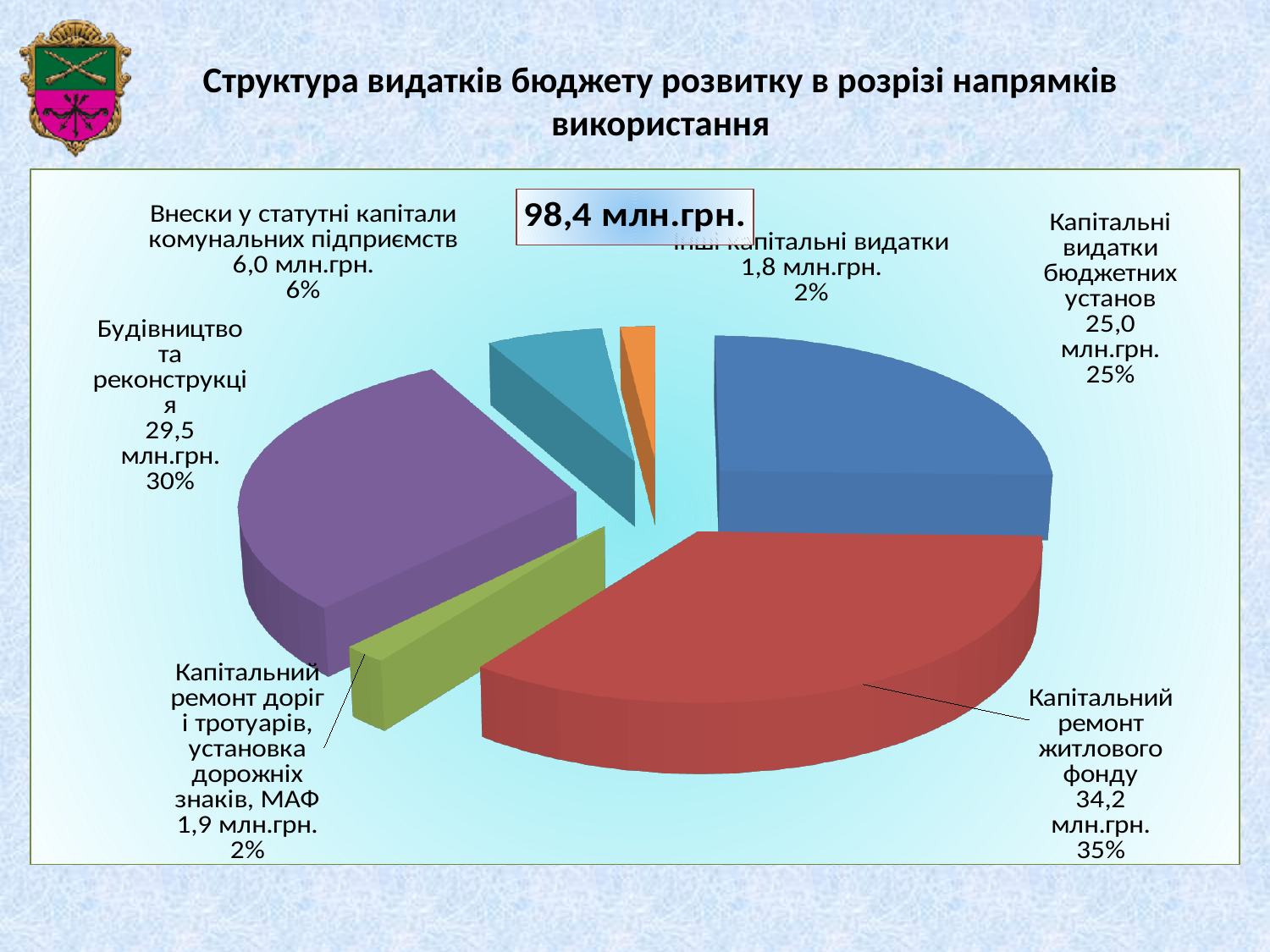
What is the value for "Капітальний ремонт житлового фонду"? 34,2 млн.грн. What total amount is shown in the box at the top of the chart? 98,4 млн.грн. What kind of chart is shown on the slide? pie chart Which category has the largest slice of the pie? Капітальний ремонт житлового фонду Which is larger: "Будівництво та реконструкція" or "Капітальні видатки бюджетних установ"? Будівництво та реконструкція What is the value for "Капітальні видатки бюджетних установ"? 25,0 млн.грн. What share of the pie does "Внески у статутні капітали комунальних підприємств" take? 6% What is the difference between "Капітальний ремонт житлового фонду" and "Будівництво та реконструкція" in млн.грн.? 4,7 млн.грн. How many slices does the pie chart have? 6 What share of the pie does "Будівництво та реконструкція" take? 30% What is the value for "Інші капітальні видатки"? 1,8 млн.грн. What is the title of the slide? Структура видатків бюджету розвитку в розрізі напрямків використання